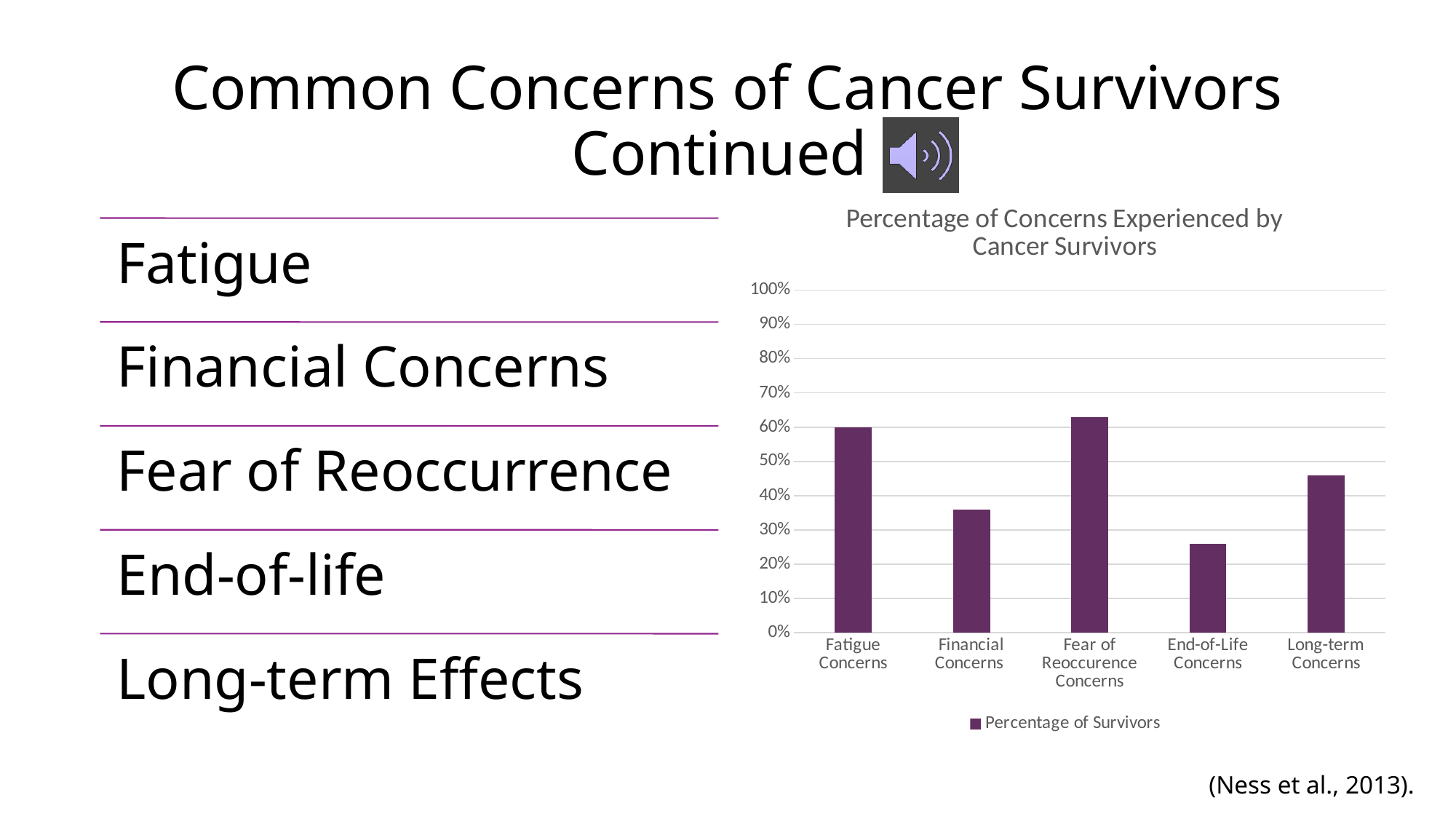
Which category has the lowest percentage of survivors? End-of-Life Concerns How many categories are plotted in the chart? 5 Is the value for Financial Concerns greater or less than 40%? less Which is larger, the value for Long-term Concerns or the value for Financial Concerns? Long-term Concerns Is the value for Long-term Concerns greater or less than 40%? greater Is the value for End-of-Life Concerns greater or less than 30%? less How many series does the chart legend list? 1 What is the name of the series shown in the legend? Percentage of Survivors What is the title of the chart? Percentage of Concerns Experienced by Cancer Survivors What type of chart is shown on the slide? bar chart Which category has the highest percentage of survivors? Fear of Reoccurence Concerns